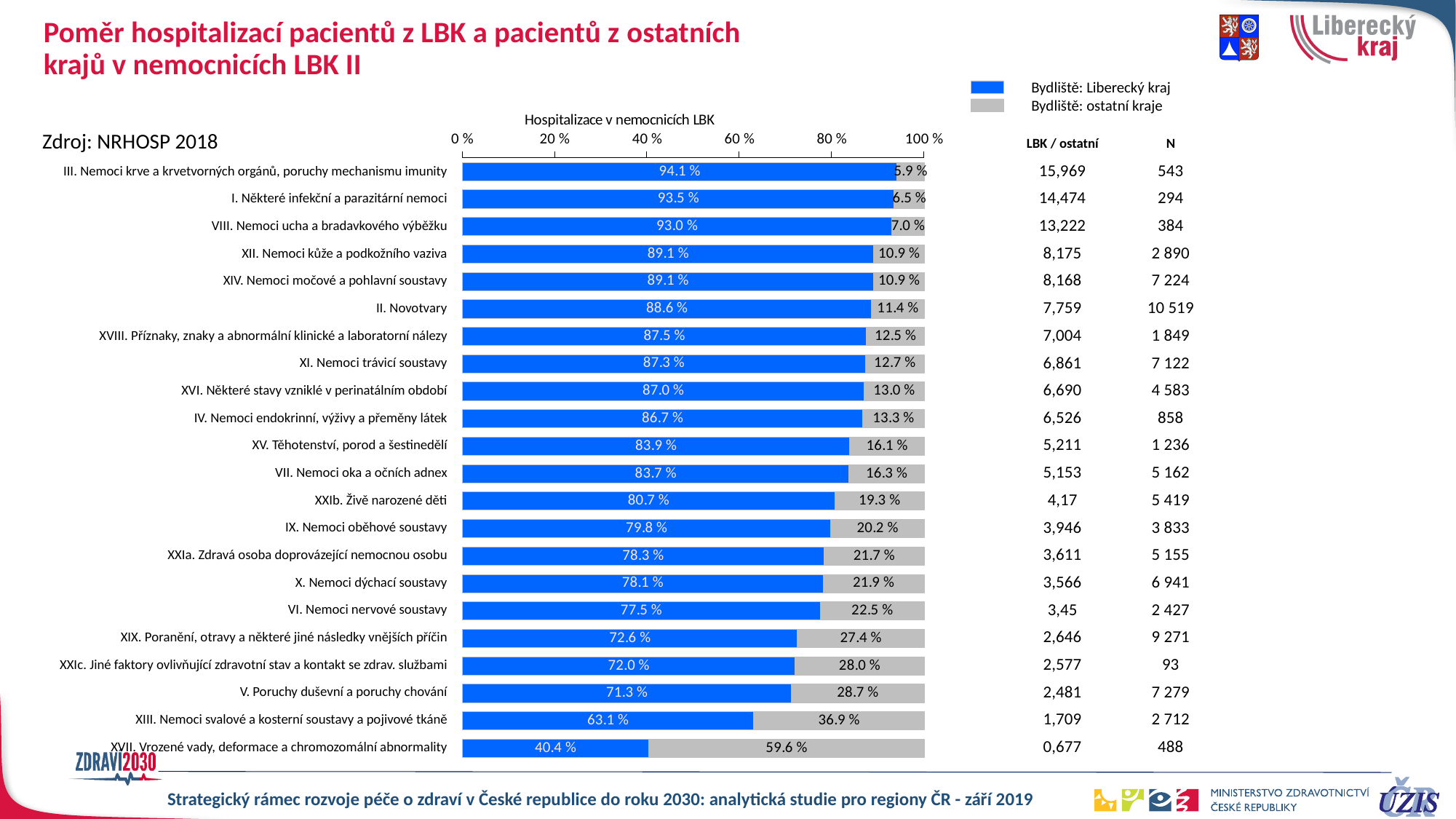
What is the difference in the Liberecký kraj share between "I. Některé infekční a parazitární nemoci" and "X. Nemoci dýchací soustavy"? 15.4 % What is the "Bydliště: ostatní kraje" share for "XIII. Nemoci svalové a kosterní soustavy a pojivové tkáně"? 36.9 % How many diagnosis categories are shown in the chart? 22 Which has a larger share of patients from other regions (ostatní kraje): "XIX. Poranění, otravy a některé jiné následky vnějších příčin" or "IX. Nemoci oběhové soustavy"? XIX. Poranění, otravy a některé jiné následky vnějších příčin Which category has the highest share of patients from Liberecký kraj? III. Nemoci krve a krvetvorných orgánů, poruchy mechanismu imunity What is the total of the two segments in the bar for "XXIb. Živě narozené děti"? 100 % What is the Liberecký kraj share for "XV. Těhotenství, porod a šestinedělí"? 83.9 % Which category has the lowest share of patients from Liberecký kraj? XVII. Vrozené vady, deformace a chromozomální abnormality How many series does the legend list? 2 Is the Liberecký kraj share for "V. Poruchy duševní a poruchy chování" greater or less than 80 %? less What type of chart is shown on the slide? stacked bar chart What percentage of hospitalizations for "II. Novotvary" are for patients with residence in Liberecký kraj? 88.6 %